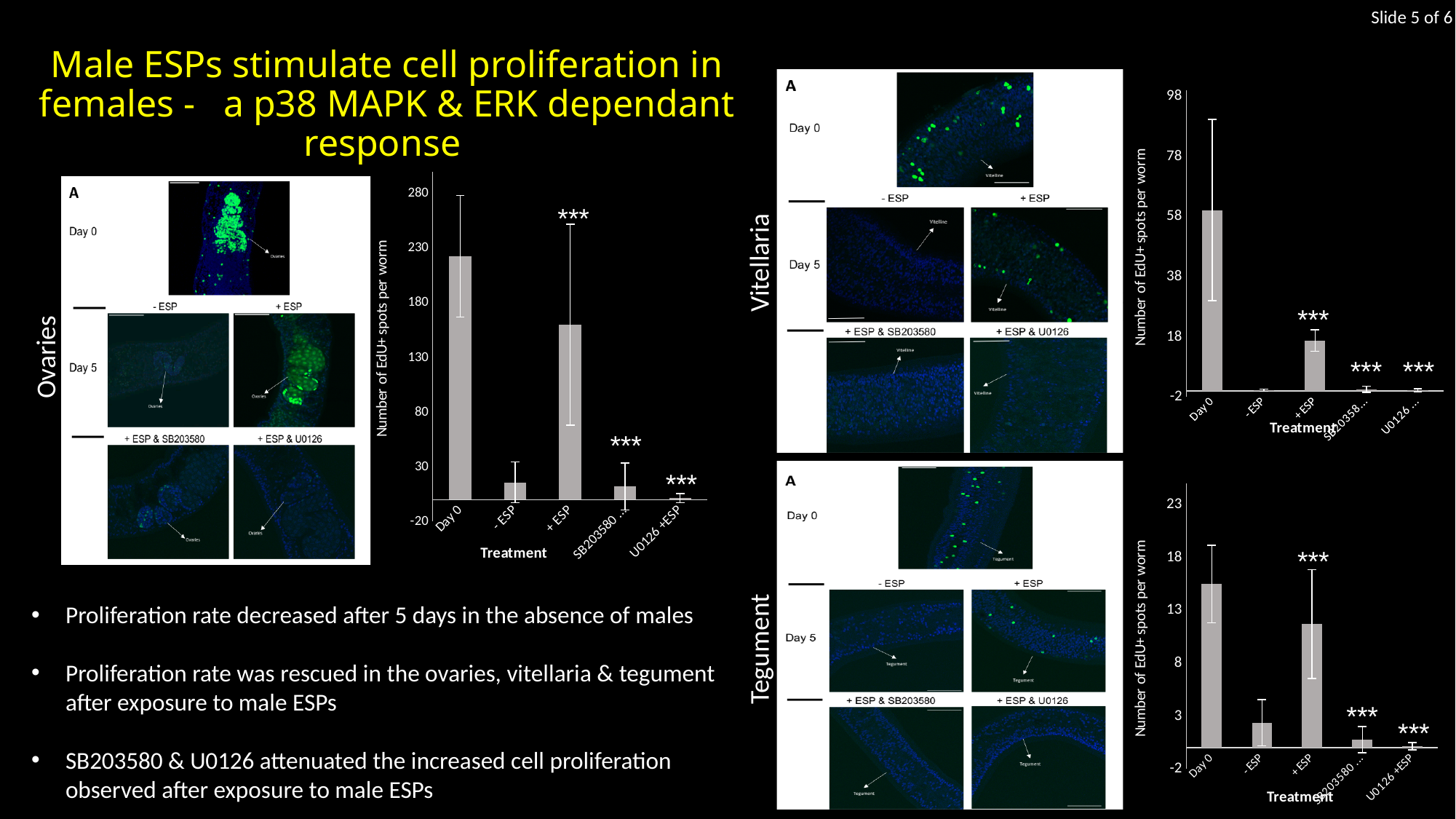
In the Ovaries chart, is the value for Day 0 greater or less than 180? greater In the Vitellaria chart (top right), which treatment has the highest number of EdU+ spots per worm? Day 0 In the Tegument chart (bottom right), which is larger, the value for Day 0 or the value for + ESP? Day 0 What kind of chart is the Ovaries chart on the left of the slide? bar chart In the Tegument chart (bottom right), is the value for + ESP greater or less than 8? greater In the Vitellaria chart (top right), is the value for Day 0 greater or less than 38? greater In the Ovaries chart, which treatment has the highest number of EdU+ spots per worm? Day 0 What is the y-axis title of the Tegument chart (bottom right)? Number of EdU+ spots per worm In the Ovaries chart, which is larger, the value for + ESP or the value for - ESP? + ESP How many treatment categories are shown on the x axis of the Ovaries chart? 5